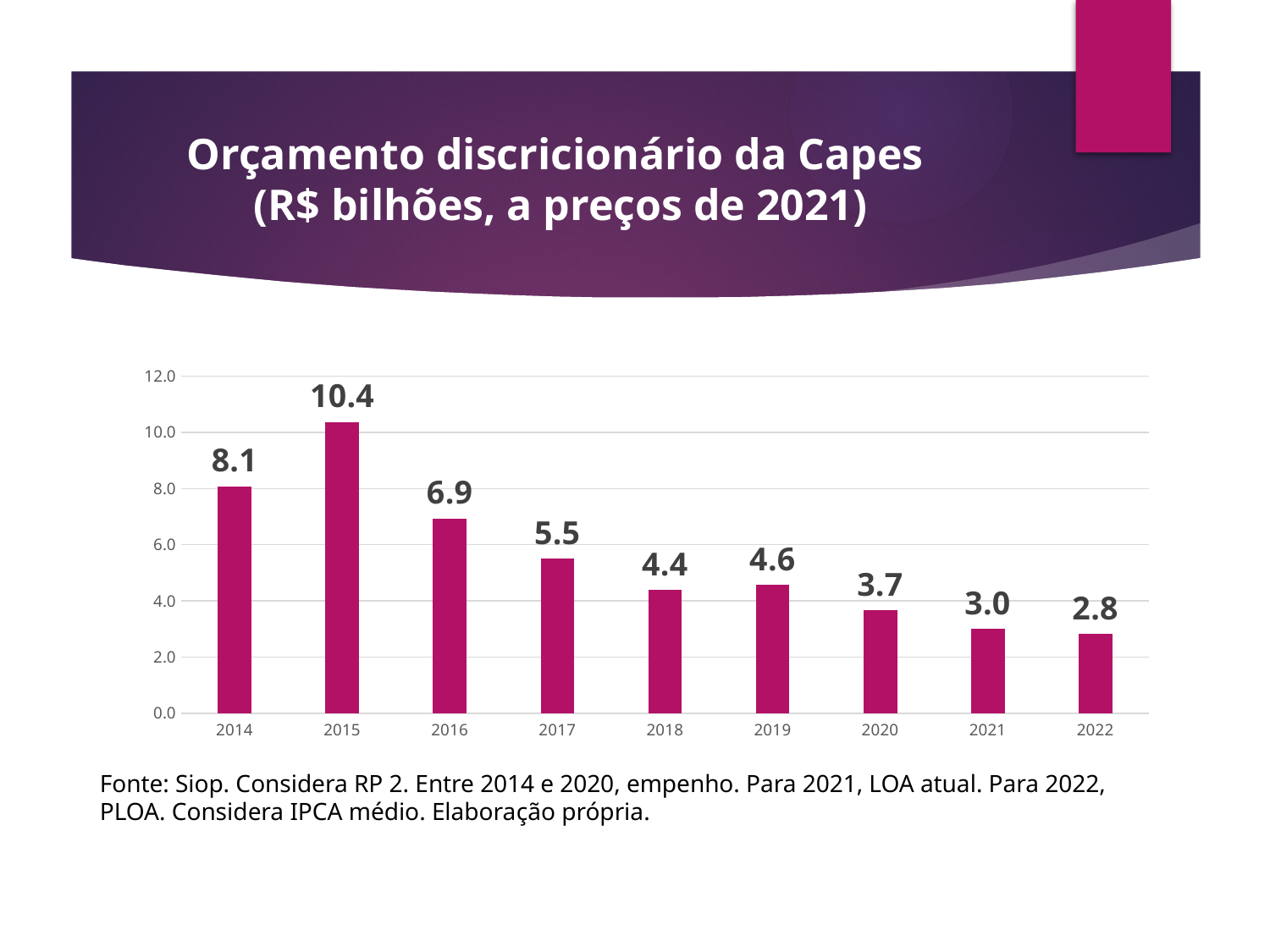
Which year has the highest value? 2015 Which year has the lowest value? 2022 What is the value for 2018? 4.4 What is the difference between the values for 2015 and 2022? 7.6 Is the value for 2014 greater or less than 6.0? greater How many years are shown on the x axis? 9 What is the value for 2022? 2.8 What is the title of the chart? Orçamento discricionário da Capes (R$ bilhões, a preços de 2021) What kind of chart is shown on the slide? bar chart Which is larger, the value for 2018 or the value for 2019? 2019 What is the value for 2015? 10.4 Do the values generally rise or fall from 2015 to 2022? fall